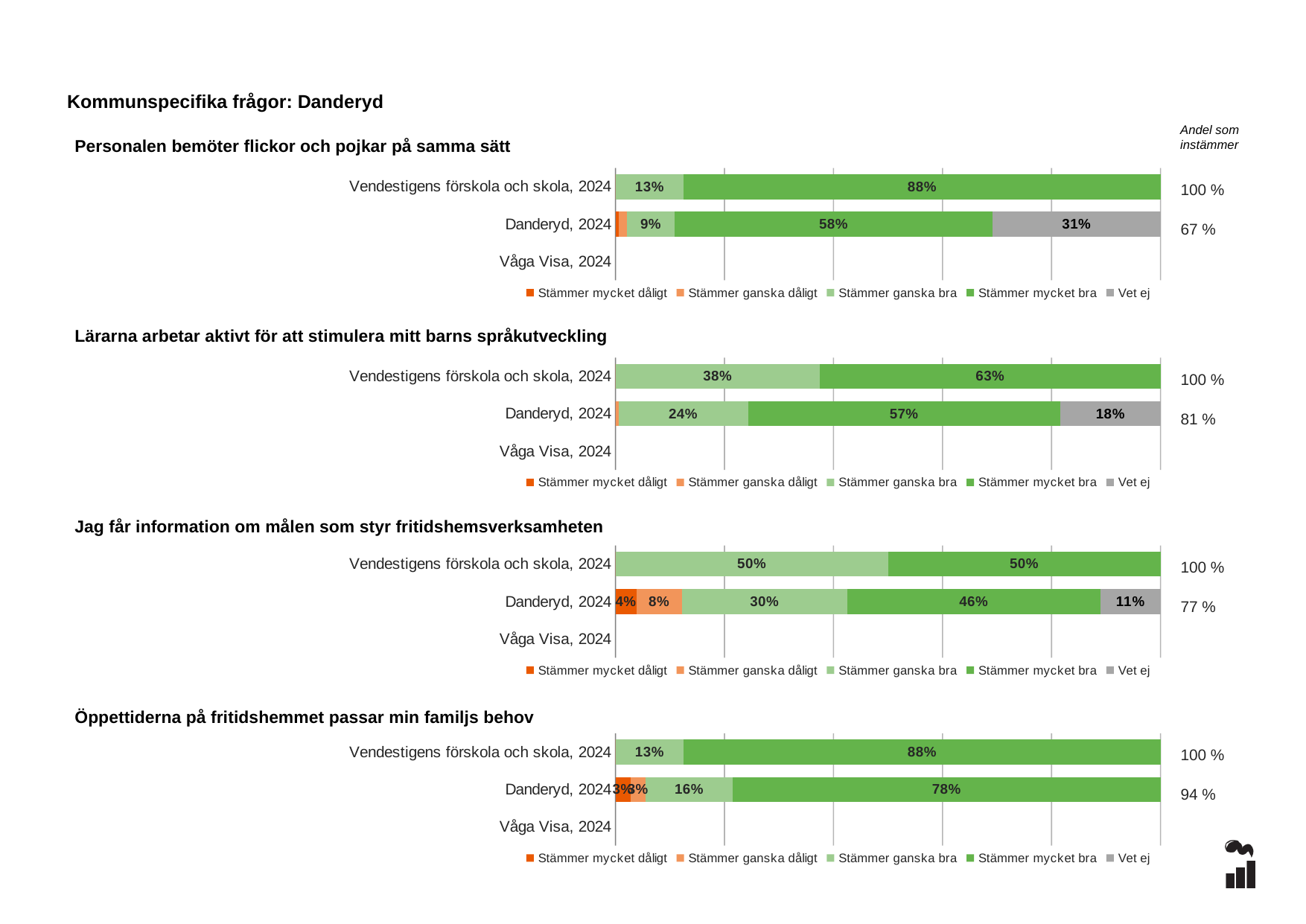
In the chart 'Öppettiderna på fritidshemmet passar min familjs behov', what is the 'Andel som instämmer' shown for Danderyd, 2024? 94 % What kind of chart is 'Lärarna arbetar aktivt för att stimulera mitt barns språkutveckling'? Stacked bar chart In the chart 'Öppettiderna på fritidshemmet passar min familjs behov', what is the 'Stämmer mycket bra' value for Danderyd, 2024? 78% In the chart 'Personalen bemöter flickor och pojkar på samma sätt', what is the 'Stämmer mycket bra' value for Vendestigens förskola och skola, 2024? 88% In the chart 'Lärarna arbetar aktivt för att stimulera mitt barns språkutveckling', what is the difference between the 'Stämmer mycket bra' values for Vendestigens förskola och skola, 2024 and Danderyd, 2024? 6% In the chart 'Personalen bemöter flickor och pojkar på samma sätt', what is the 'Vet ej' value for Danderyd, 2024? 31% How many series does the legend of the chart 'Jag får information om målen som styr fritidshemsverksamheten' list? 5 In the chart 'Lärarna arbetar aktivt för att stimulera mitt barns språkutveckling', what is the 'Stämmer ganska bra' value for Vendestigens förskola och skola, 2024? 38% In the chart 'Jag får information om målen som styr fritidshemsverksamheten', what is the 'Stämmer ganska dåligt' value for Danderyd, 2024? 8% How many categories are listed on the y axis of the chart 'Öppettiderna på fritidshemmet passar min familjs behov'? 3 In the chart 'Jag får information om målen som styr fritidshemsverksamheten', which is larger for Danderyd, 2024: 'Stämmer ganska bra' or 'Stämmer mycket bra'? Stämmer mycket bra In the chart 'Personalen bemöter flickor och pojkar på samma sätt', what is the 'Andel som instämmer' shown for Danderyd, 2024? 67 %